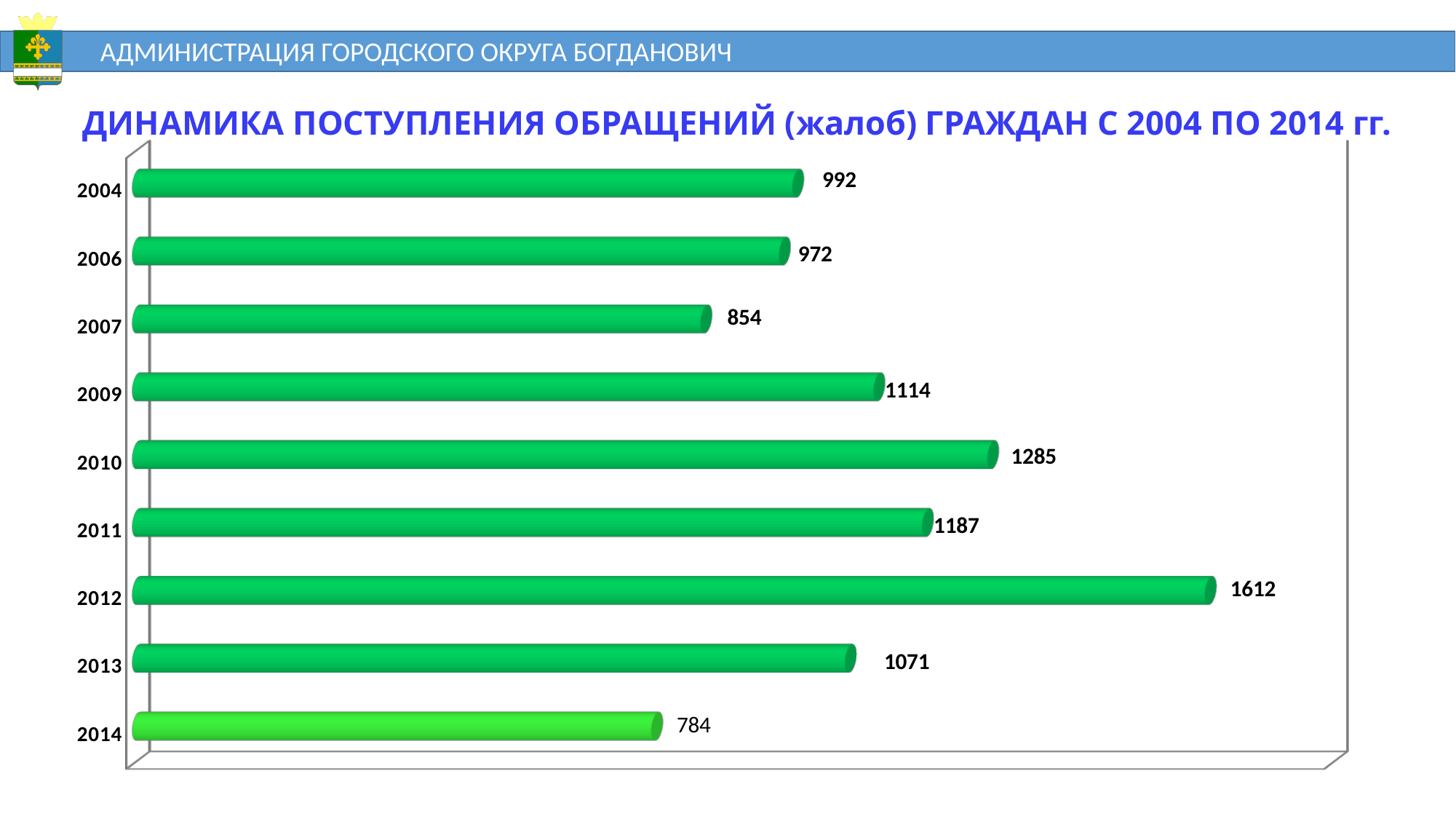
What is the difference between the values for 2004 and 2006? 20 Which year has the highest value? 2012 Does the value rise or fall from 2013 to 2014? fall What is the value for 2007? 854 How many years are shown in the chart? 9 What is the difference between the values for 2012 and 2013? 541 Which year has the lowest value? 2014 What colour are the bars in the chart? green What is the value for 2012? 1612 What kind of chart is shown on the slide? bar chart Which is larger, the value for 2010 or the value for 2011? 2010 What is the value for 2014? 784